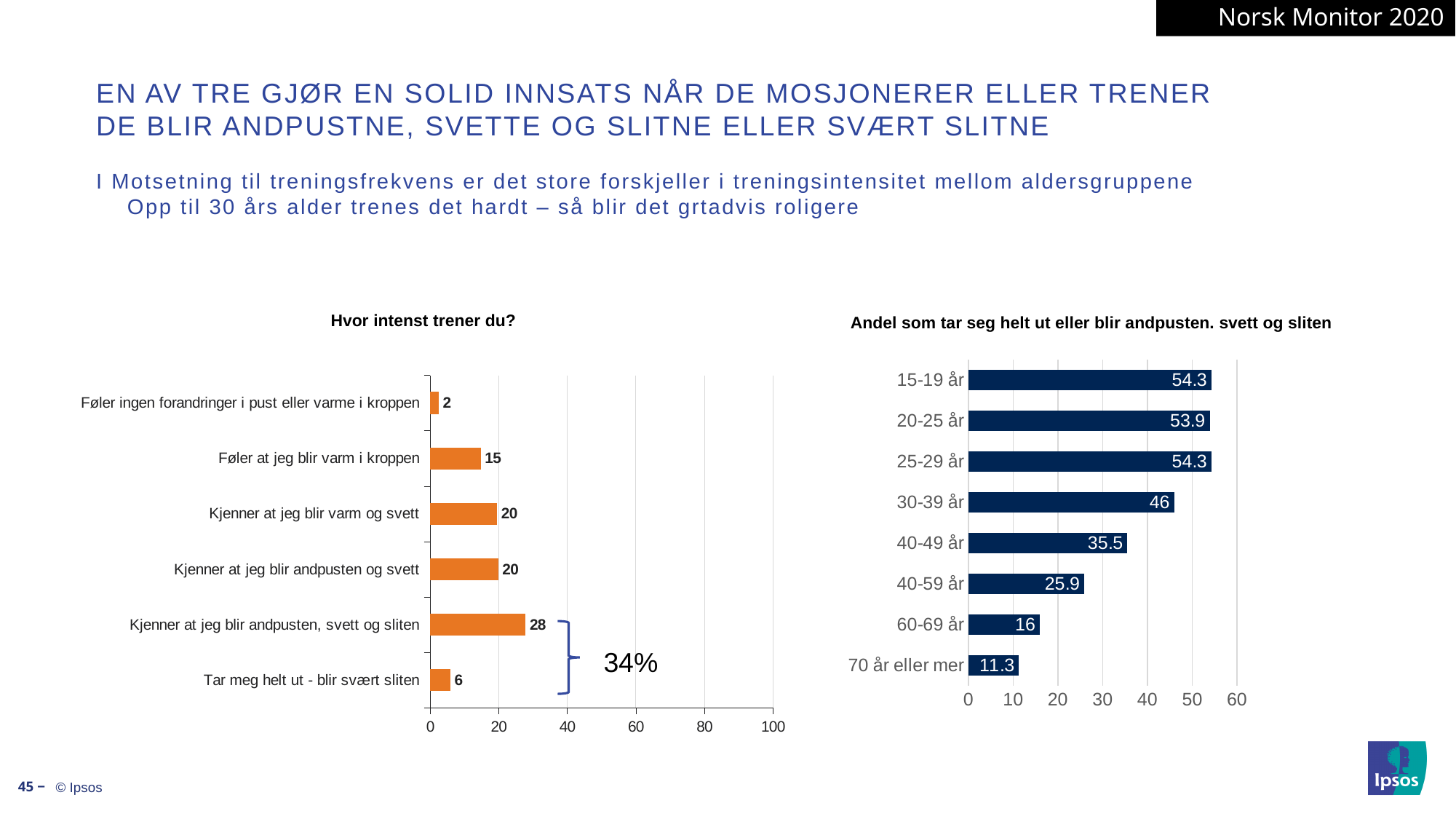
In the chart 'Hvor intenst trener du?', which category has the highest value? Kjenner at jeg blir andpusten, svett og sliten What kind of chart is 'Andel som tar seg helt ut eller blir andpusten. svett og sliten'? Bar chart In the chart 'Hvor intenst trener du?', what is the difference between 'Kjenner at jeg blir andpusten, svett og sliten' and 'Tar meg helt ut - blir svært sliten'? 22 In the chart 'Andel som tar seg helt ut eller blir andpusten. svett og sliten', which age group has the lowest value? 70 år eller mer In the chart 'Hvor intenst trener du?', which category has the lowest value? Føler ingen forandringer i pust eller varme i kroppen In the chart 'Hvor intenst trener du?', what is the value for 'Kjenner at jeg blir andpusten, svett og sliten'? 28 In the chart 'Hvor intenst trener du?', what percentage is shown next to the bracket grouping the two most intense categories? 34% In the chart 'Hvor intenst trener du?', how many categories are shown? 6 In the chart 'Andel som tar seg helt ut eller blir andpusten. svett og sliten', which is larger: '40-49 år' or '40-59 år'? 40-49 år In the chart 'Andel som tar seg helt ut eller blir andpusten. svett og sliten', how many age groups are shown? 8 In the chart 'Andel som tar seg helt ut eller blir andpusten. svett og sliten', what is the value for '30-39 år'? 46 In the chart 'Andel som tar seg helt ut eller blir andpusten. svett og sliten', what is the difference between '20-25 år' and '60-69 år'? 37.9